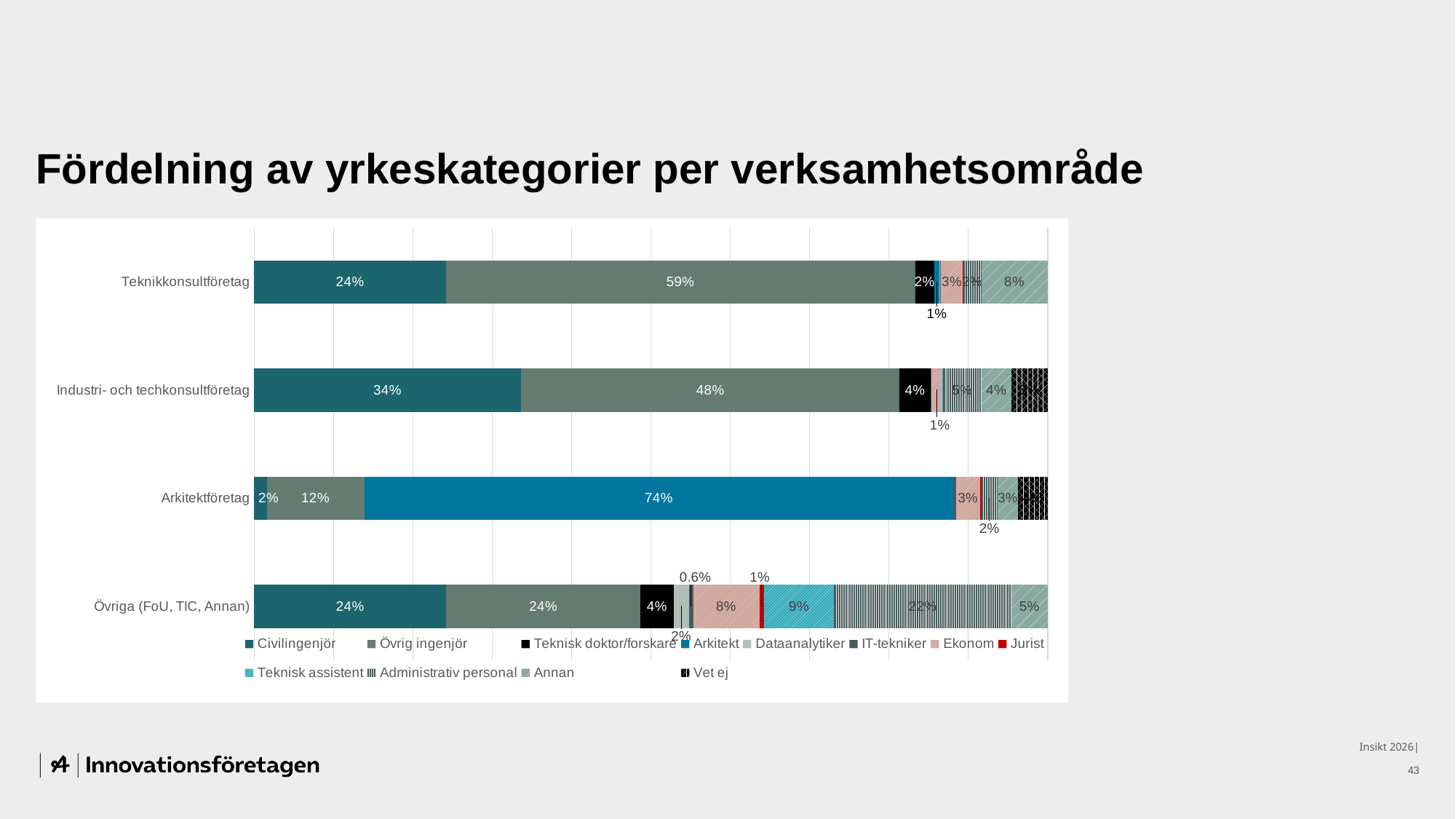
What share of Övriga (FoU, TIC, Annan) is Teknisk assistent? 9% What share of Teknikkonsultföretag is Övrig ingenjör? 59% How many series does the legend list? 12 Which verksamhetsområde has the lowest share of Civilingenjör? Arkitektföretag Which verksamhetsområde has the highest share of Civilingenjör? Industri- och techkonsultföretag How many verksamhetsområden (categories) are shown on the y axis? 4 What kind of chart is shown on the slide? Stacked bar chart What share of Övriga (FoU, TIC, Annan) is Administrativ personal? 22% What is the difference in the Övrig ingenjör share between Teknikkonsultföretag and Industri- och techkonsultföretag? 11 percentage points What share of Industri- och techkonsultföretag is Civilingenjör? 34% What share of Arkitektföretag is Arkitekt? 74% Which is larger: the Civilingenjör share in Teknikkonsultföretag or in Arkitektföretag? Teknikkonsultföretag